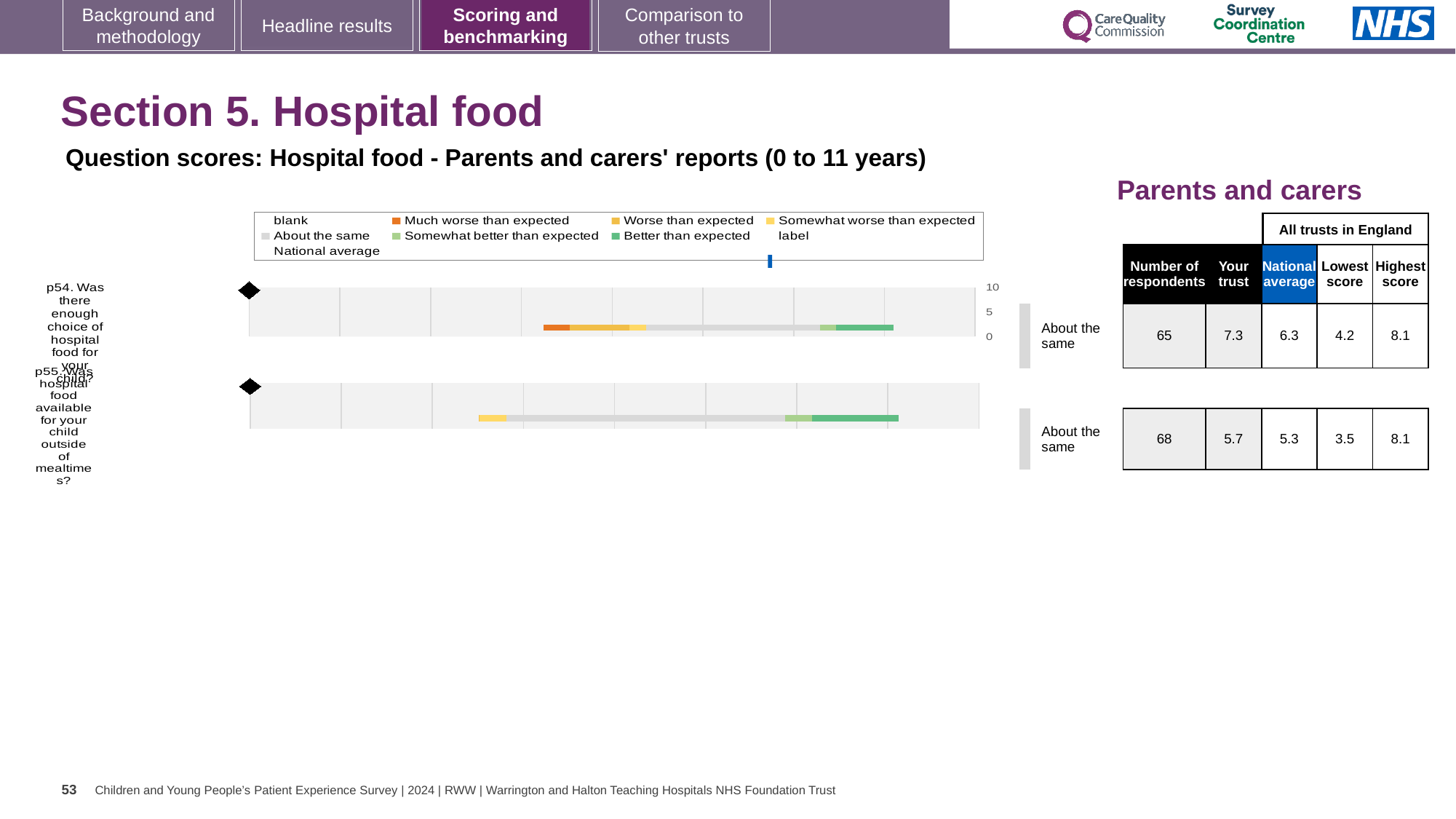
What is the national average score for p55 (hospital food available outside of mealtimes)? 5.3 What kind of chart is used to show the question scores on this slide? bar chart What is the difference between the 'Your trust' score and the national average for p54? 1.0 What is the lowest score among all trusts in England for p55? 3.5 What benchmark rating is given for p54 (enough choice of hospital food)? About the same What benchmark rating is given for p55 (hospital food available outside of mealtimes)? About the same What is the maximum value shown on the chart's score axis? 10 How many respondents answered p55 (hospital food available outside of mealtimes)? 68 Which question has the higher 'Your trust' score, p54 or p55? p54 How many questions (categories) are plotted in the chart? 2 Which legend entry is shown in dark orange? Much worse than expected What is the 'Your trust' score for p54 (enough choice of hospital food)? 7.3